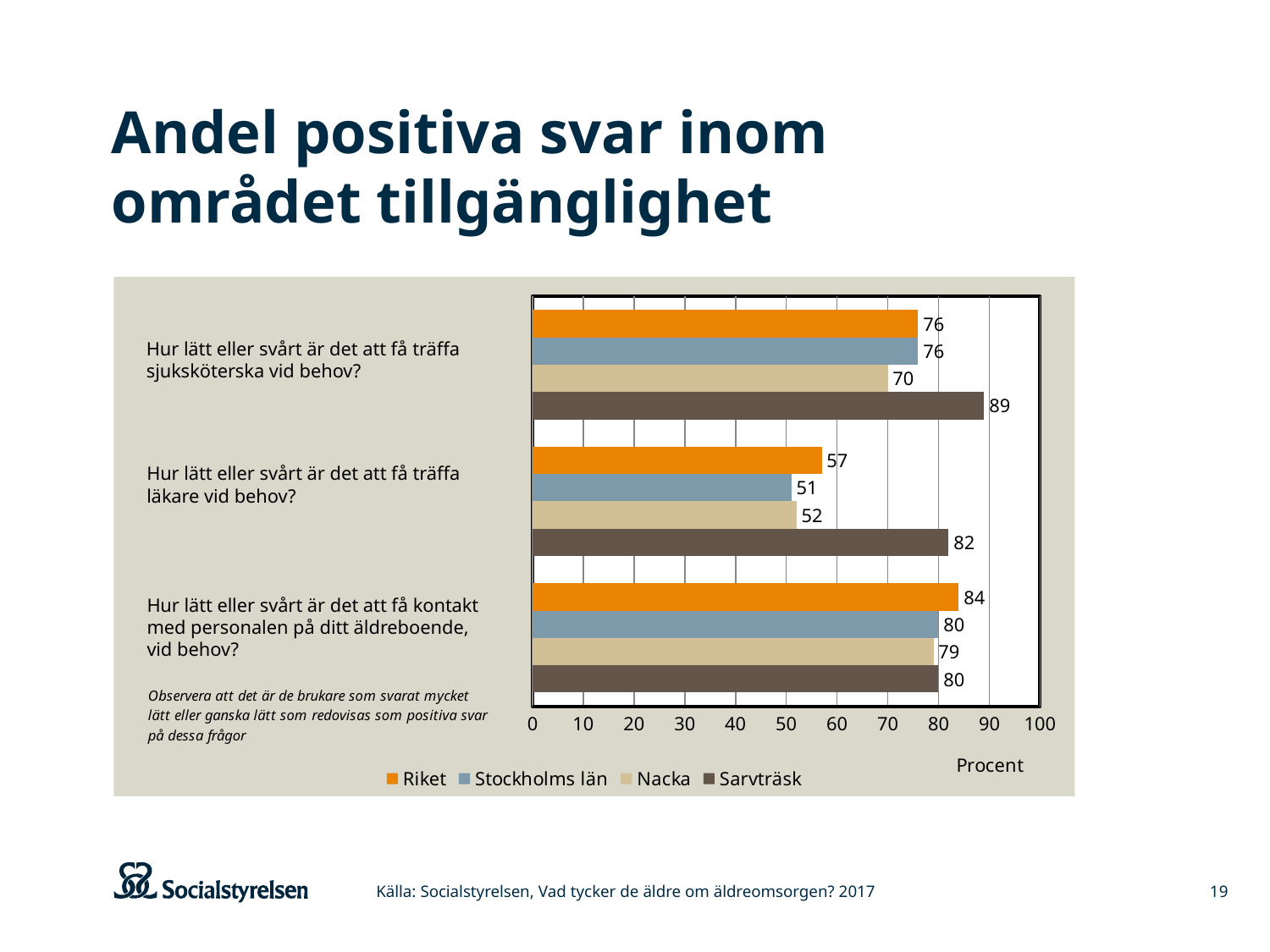
Which series has the highest value on the question about meeting a doctor when needed (läkare)? Sarvträsk Which is larger: Riket or Nacka on the question about contacting staff at the care home? Riket What kind of chart is shown on the slide? Bar chart What is the value for Riket on the question about contacting staff at the care home (personalen på ditt äldreboende)? 84 What unit is shown on the x axis of the chart? Procent How many question categories are shown on the chart? 3 What is the value for Sarvträsk on the question about meeting a nurse when needed (sjuksköterska)? 89 Which series has the lowest value on the question about meeting a doctor when needed (läkare)? Stockholms län What is the value for Nacka on the question about meeting a nurse when needed (sjuksköterska)? 70 What is the difference between Sarvträsk and Riket on the question about meeting a doctor when needed (läkare)? 25 How many series does the legend list? 4 What is the value for Stockholms län on the question about meeting a doctor when needed (läkare)? 51